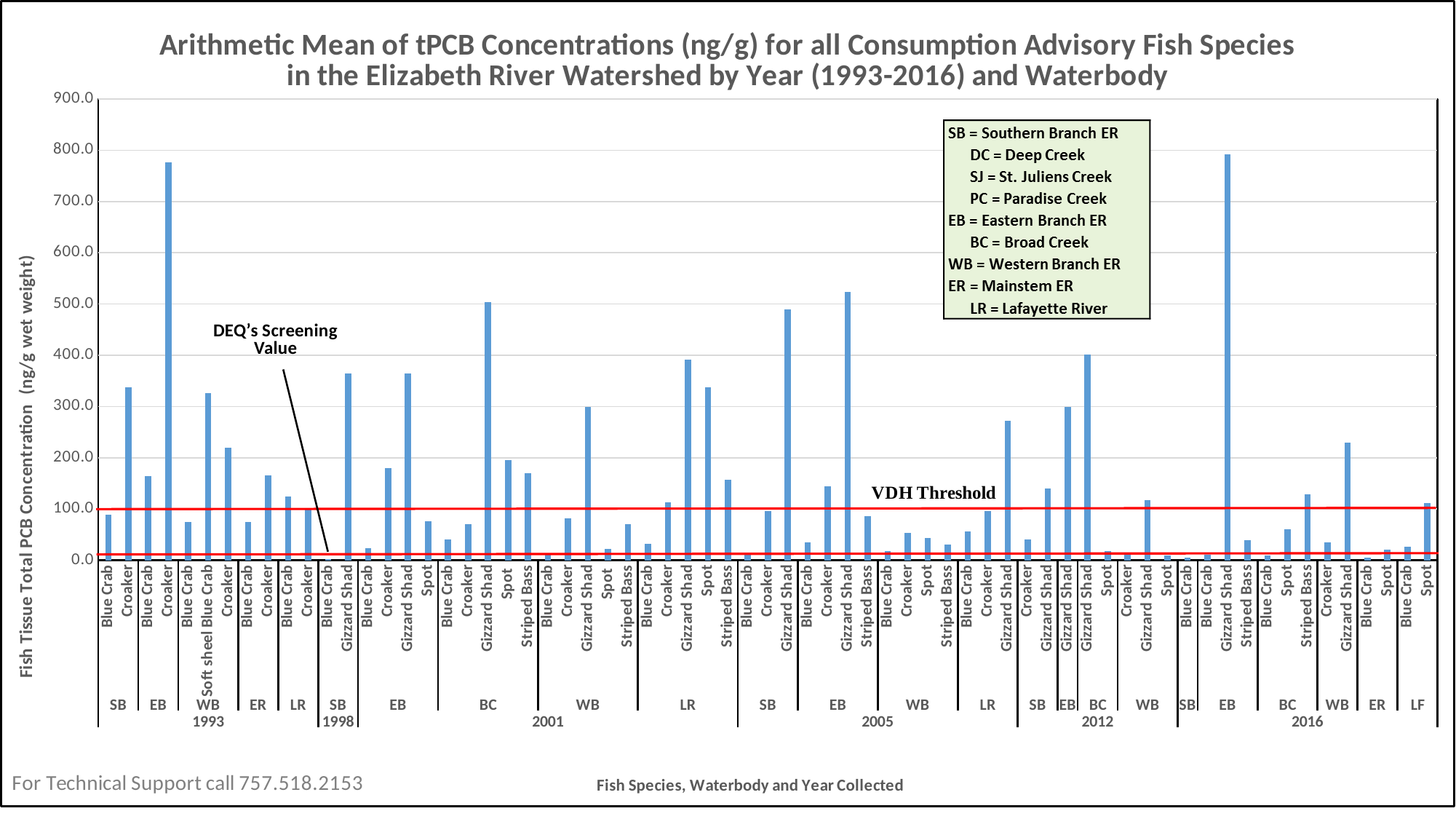
Is the value for Blue Crab in SB in 1993 greater or less than 100? less How many collection years are labelled along the x axis? 6 Is the value for Gizzard Shad in SB in 2005 greater or less than 400? greater Is the value for Gizzard Shad in BC in 2001 greater or less than 400? greater According to the legend box, what does LR stand for? Lafayette River What kind of chart is shown on the slide? bar chart Which is larger in 1993: the value for Croaker in EB or the value for Croaker in SB? Croaker in EB Which is larger in 2001: the value for Gizzard Shad in BC or the value for Gizzard Shad in LR? Gizzard Shad in BC